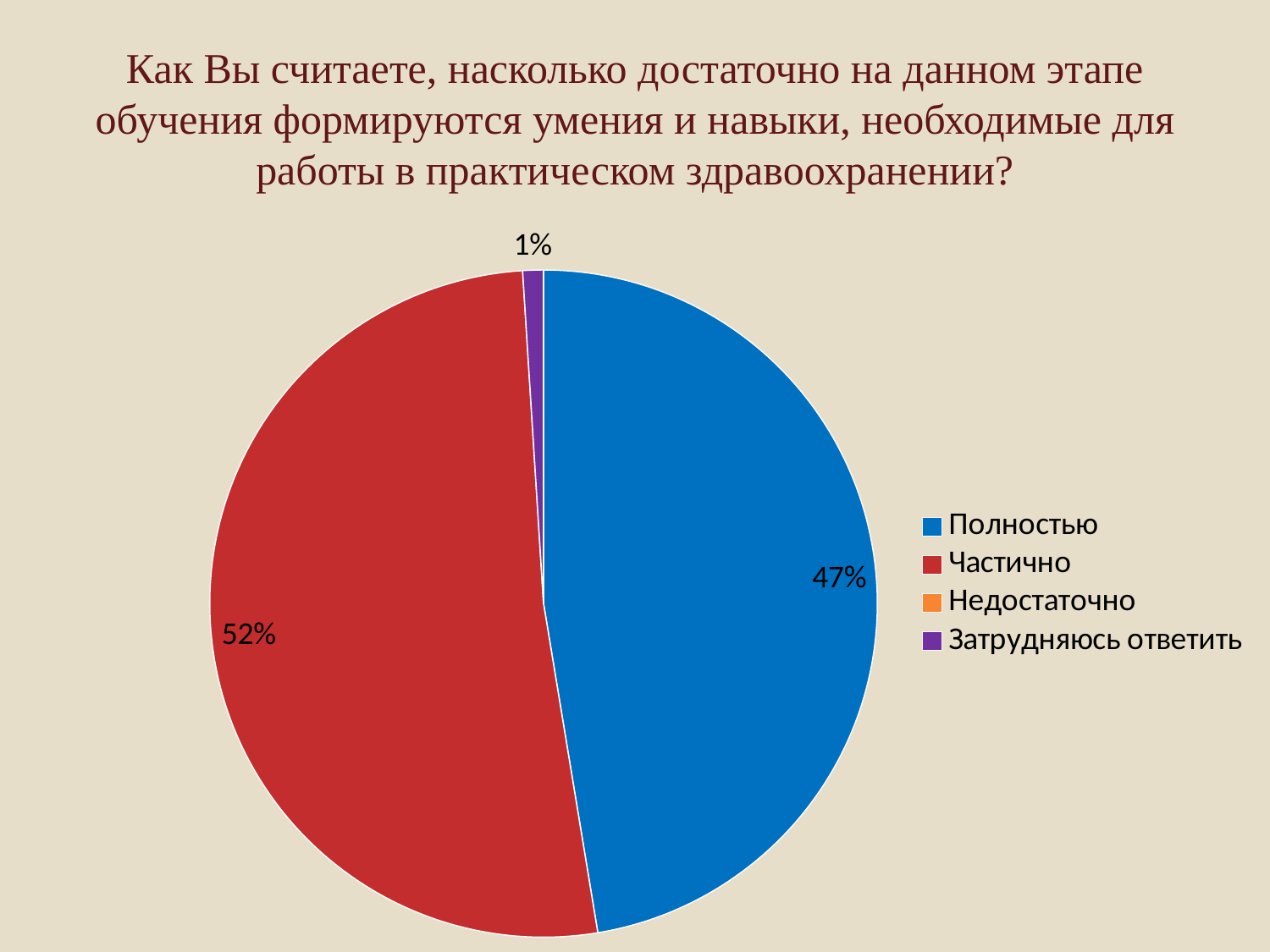
What colour represents the category "Частично" in the pie chart? Red What share of the pie is labelled for the category "Полностью"? 47% Of the slices with a printed percentage, which category has the smallest? Затрудняюсь ответить Is the share for "Полностью" greater or less than 50%? less What share of the pie is labelled for the category "Затрудняюсь ответить"? 1% Which category has the largest slice of the pie? Частично Which is larger, the share for "Полностью" or the share for "Частично"? Частично How many categories are listed in the legend? 4 What type of chart is shown on the slide? Pie chart Which legend category is shown in blue? Полностью What share of the pie is labelled for the category "Частично"? 52% By how many percentage points does the share for "Частично" exceed the share for "Полностью"? 5 percentage points